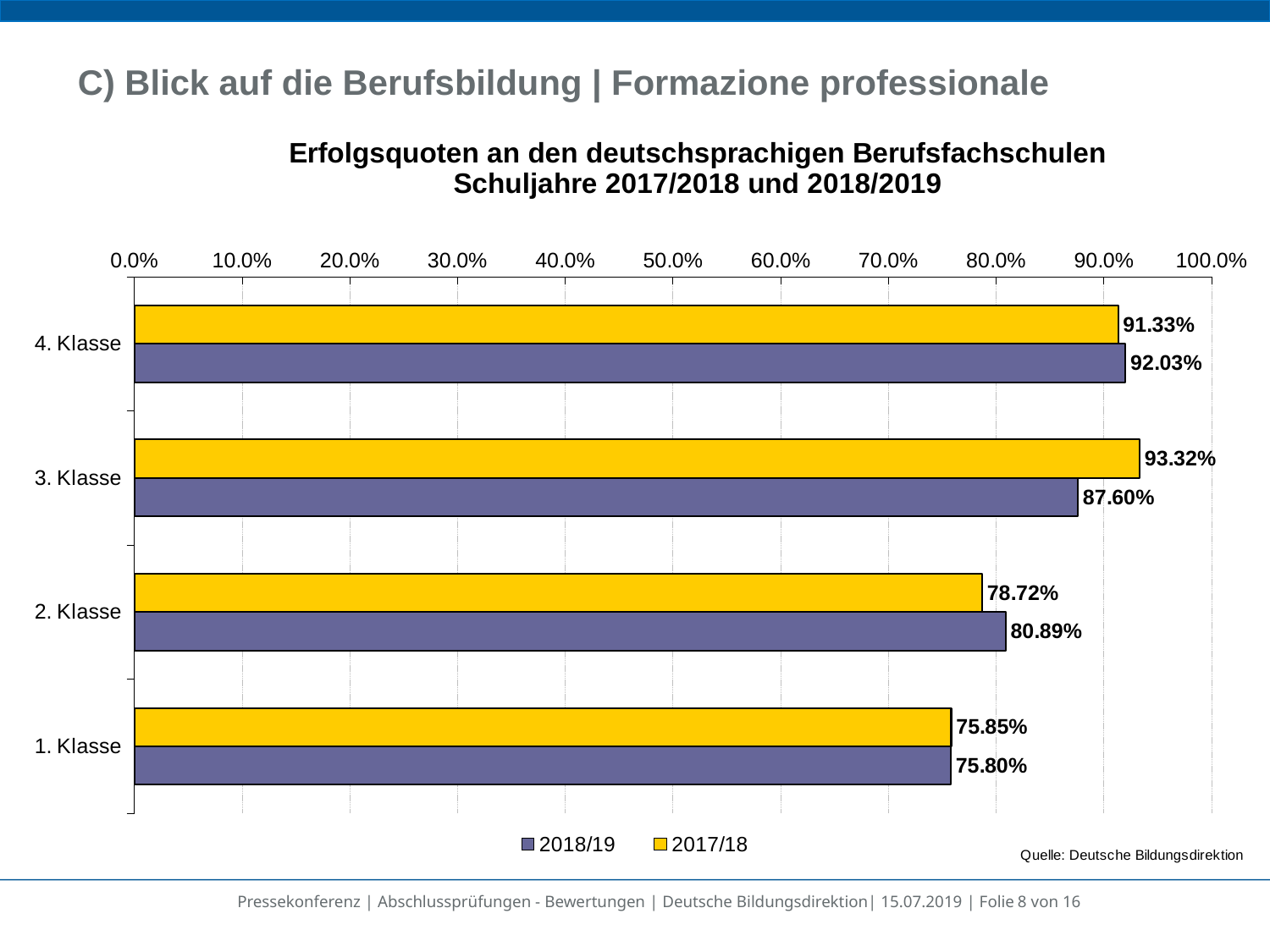
How many series does the legend list? 2 What is the difference between the 2017/18 and 2018/19 values for 3. Klasse? 5.72 percentage points What is the value for 4. Klasse in the 2018/19 series? 92.03% Is the 2018/19 value for 2. Klasse greater or less than 80.0%? greater What kind of chart is shown on the slide? Bar chart What is the success rate for 2. Klasse in 2018/19? 80.89% Which class has the lowest success rate in the 2018/19 series? 1. Klasse What is the success rate for 3. Klasse in 2017/18? 93.32% Which class has the highest success rate in the 2017/18 series? 3. Klasse How many classes (categories) are shown on the chart? 4 What is the difference between the 2018/19 and 2017/18 values for 2. Klasse? 2.17 percentage points For 3. Klasse, which series has the larger value, 2017/18 or 2018/19? 2017/18